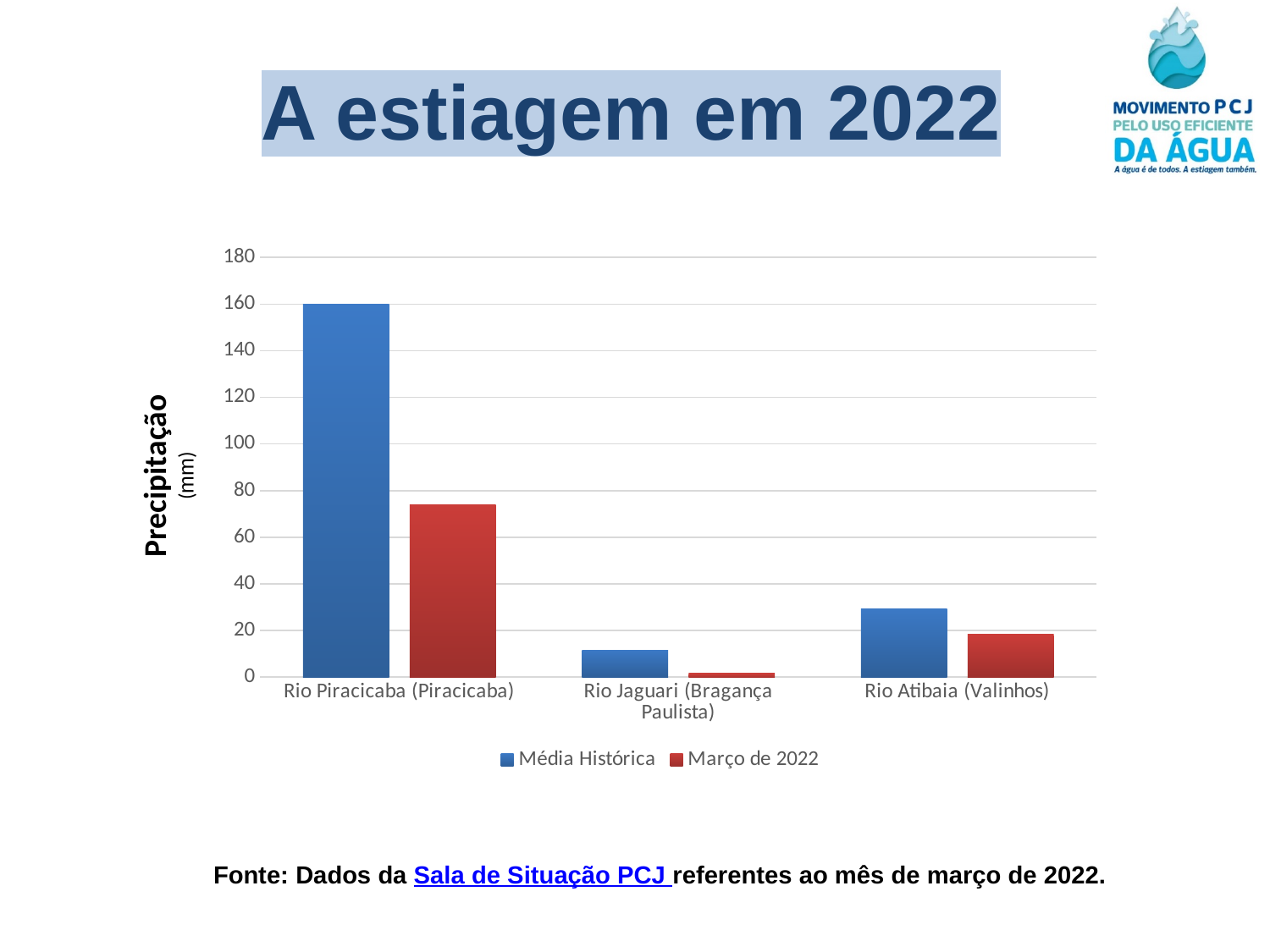
Which category has the lowest Março de 2022 value? Rio Jaguari (Bragança Paulista) Is the Média Histórica value for Rio Jaguari (Bragança Paulista) greater or less than 20? less What colour are the Março de 2022 bars? red For Rio Atibaia (Valinhos), which is larger: Média Histórica or Março de 2022? Média Histórica What is the label of the y axis? Precipitação (mm) How many series does the legend list? 2 What kind of chart is shown on the slide? bar chart Which category has the highest Média Histórica value? Rio Piracicaba (Piracicaba) Is the Média Histórica value for Rio Atibaia (Valinhos) greater or less than 40? less Is the Março de 2022 value for Rio Piracicaba (Piracicaba) greater or less than 60? greater How many river categories are shown on the x axis? 3